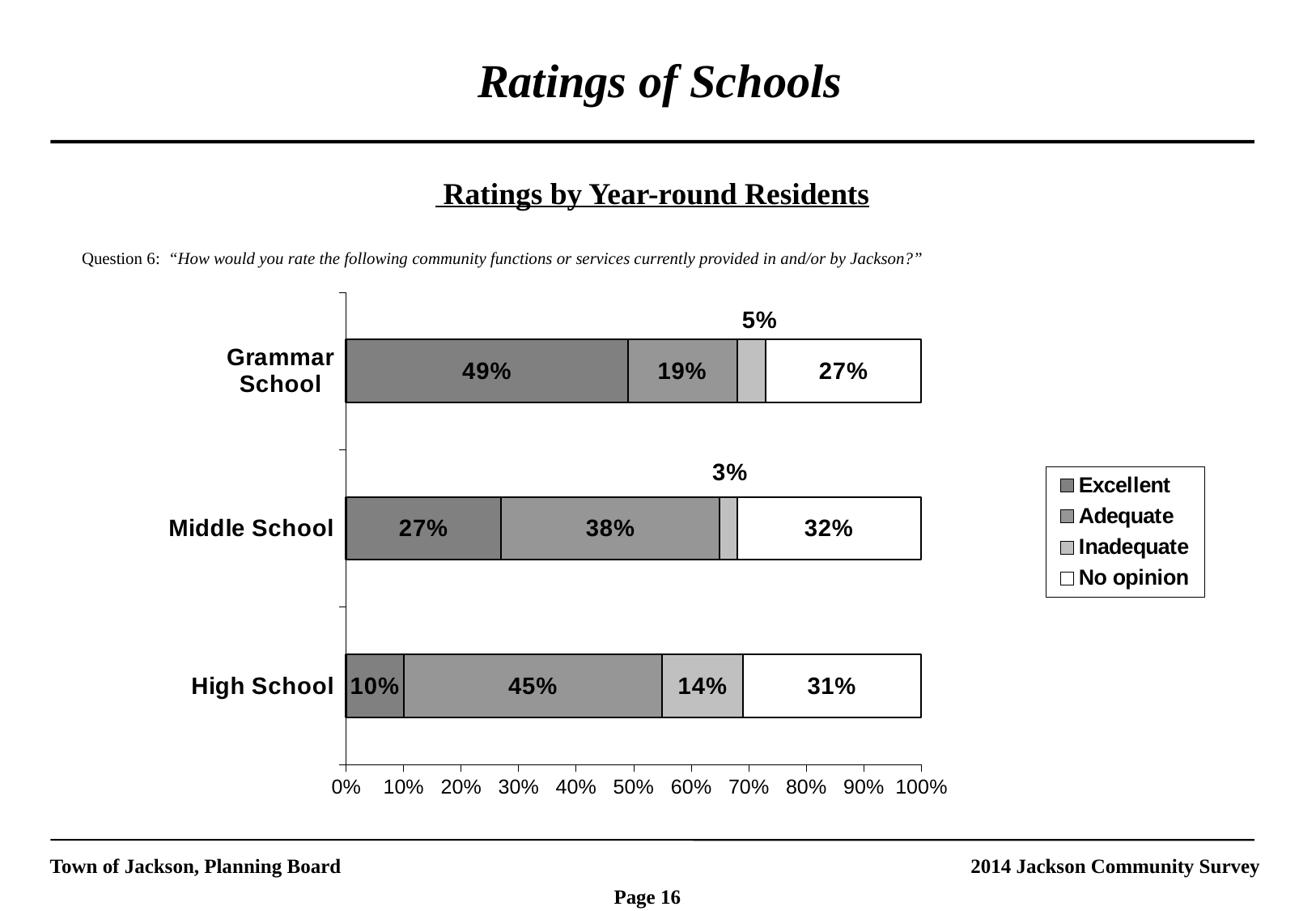
How many schools are shown on the chart? 3 What percentage of year-round residents rated the Grammar School as Excellent? 49% Which legend entry is shown in white? No opinion How many series does the legend list? 4 Which school received the lowest Inadequate rating? Middle School What kind of chart is shown on the slide? Stacked bar chart Which is larger: the Excellent rating for the Middle School or the Excellent rating for the High School? Middle School Which school received the highest Excellent rating? Grammar School What is the difference between the Adequate ratings for the High School and the Grammar School? 26% What percentage of year-round residents had No opinion about the Middle School? 32% What is the total of the Excellent and Adequate ratings for the Middle School? 65% What percentage of year-round residents rated the High School as Inadequate? 14%